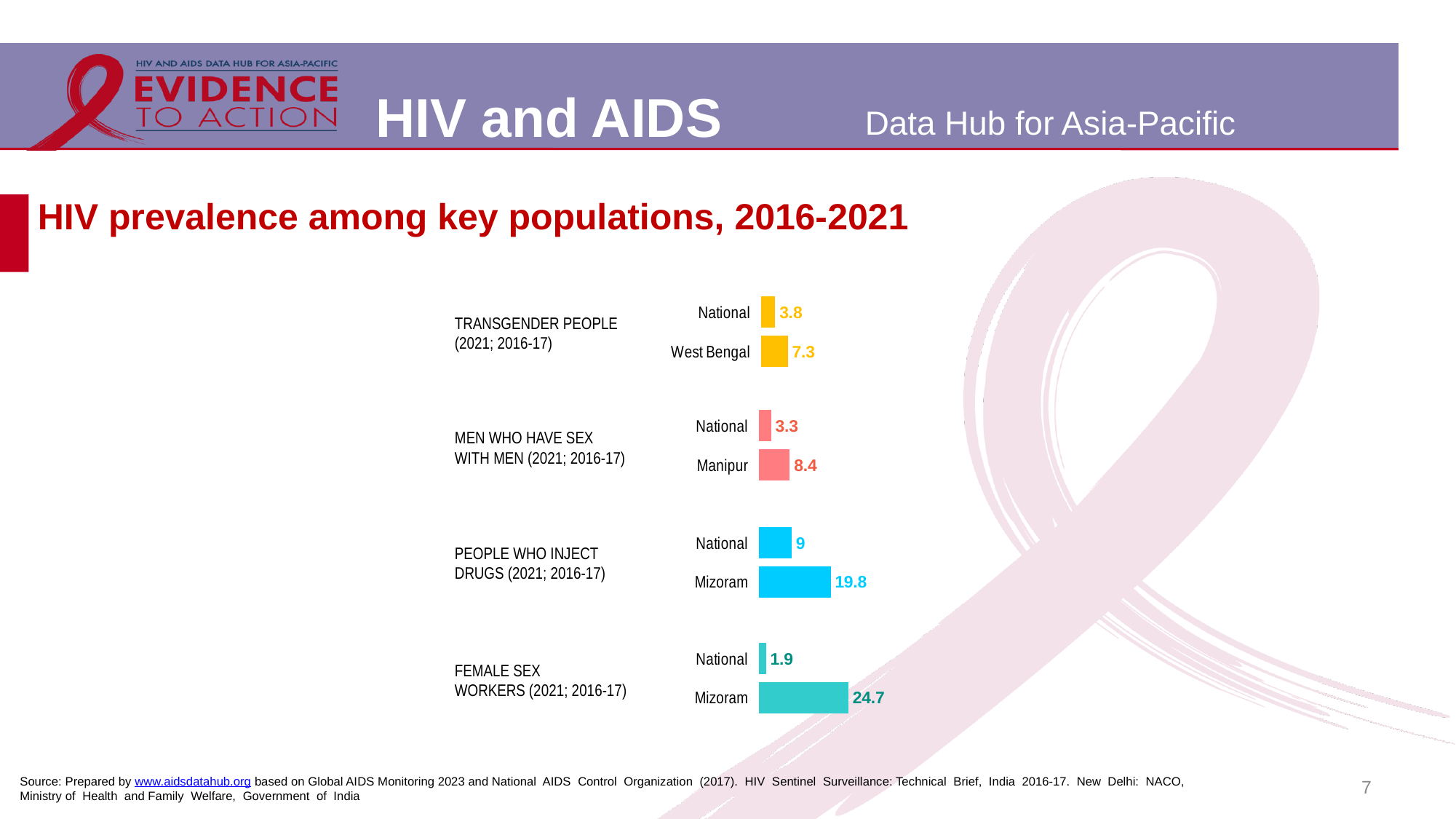
Across all four charts on the slide, which bar has the highest value? Mizoram (Female Sex Workers), 24.7 How many bars are shown in the Female Sex Workers chart? 2 In the People Who Inject Drugs chart, what is the National value? 9 In the Female Sex Workers chart, what is the value for Mizoram? 24.7 In the Men Who Have Sex With Men chart, which is larger, the National value or the Manipur value? Manipur What type of chart is used to show HIV prevalence among key populations on this slide? Bar chart Across all four charts on the slide, which bar has the lowest value? National (Female Sex Workers), 1.9 In the Transgender People chart, what is the HIV prevalence value for West Bengal? 7.3 In the Female Sex Workers chart, what is the National value? 1.9 In the Men Who Have Sex With Men chart, what is the value for Manipur? 8.4 In the People Who Inject Drugs chart, what is the difference between the Mizoram value and the National value? 10.8 In the Transgender People chart, what is the difference between the West Bengal value and the National value? 3.5